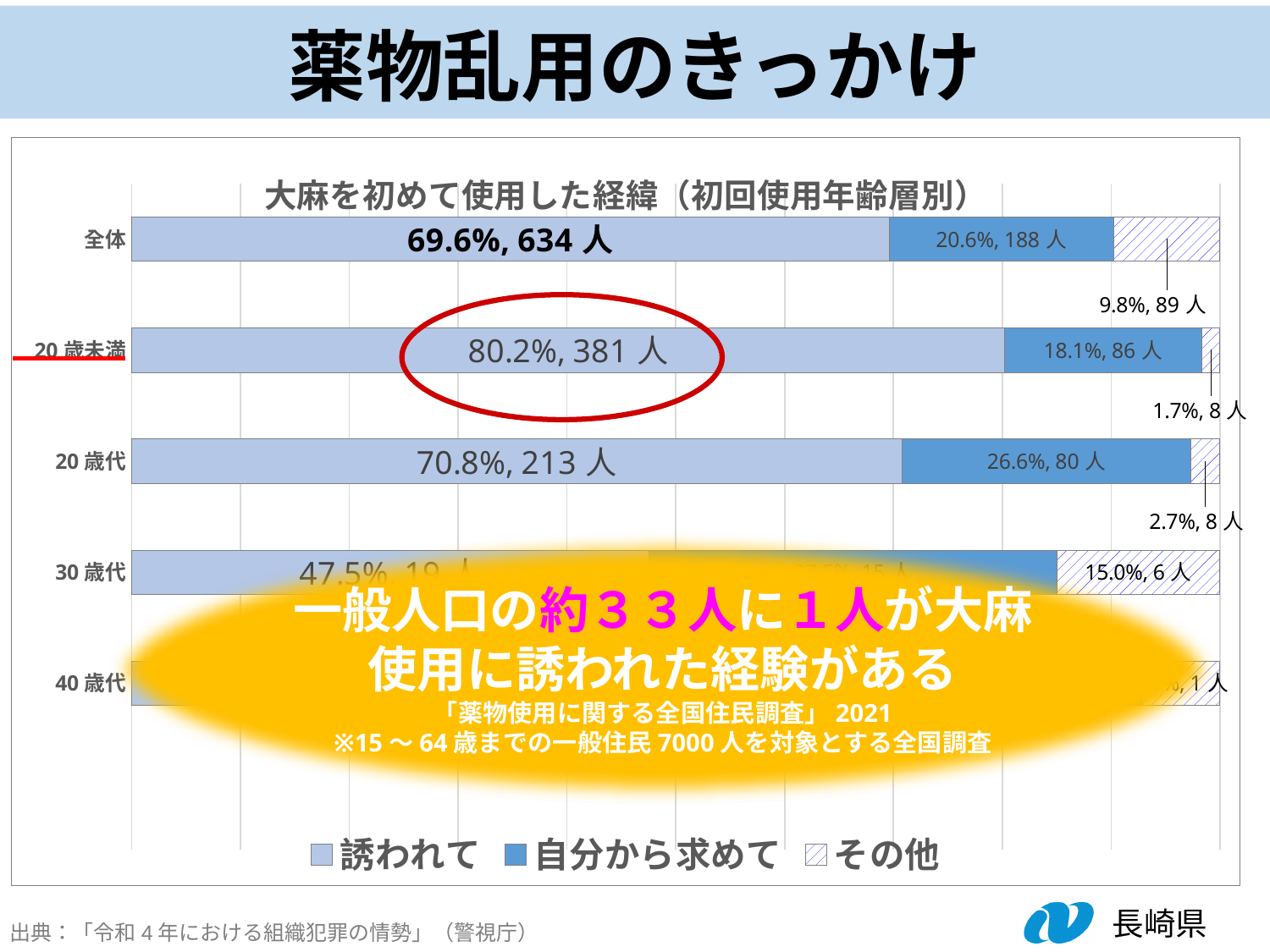
What is the difference in percentage points between 誘われて for 20歳未満 and 誘われて for 20歳代? 9.4 What is the value of 誘われて for 全体? 69.6%, 634人 What is the value of 自分から求めて for 20歳代? 26.6%, 80人 What are the three series listed in the chart legend? 誘われて, 自分から求めて, その他 How many series does the chart legend list? 3 What is the title of the chart? 大麻を初めて使用した経緯（初回使用年齢層別） What is the value of その他 for 全体? 9.8%, 89人 Which age group has the highest percentage for 誘われて among 全体, 20歳未満 and 20歳代? 20歳未満 What is the value of 誘われて for 20歳未満? 80.2%, 381人 Which is larger: the 自分から求めて percentage for 20歳未満 or for 20歳代? 20歳代 What kind of chart is shown on the slide? stacked bar chart What is the value of その他 for 30歳代? 15.0%, 6人